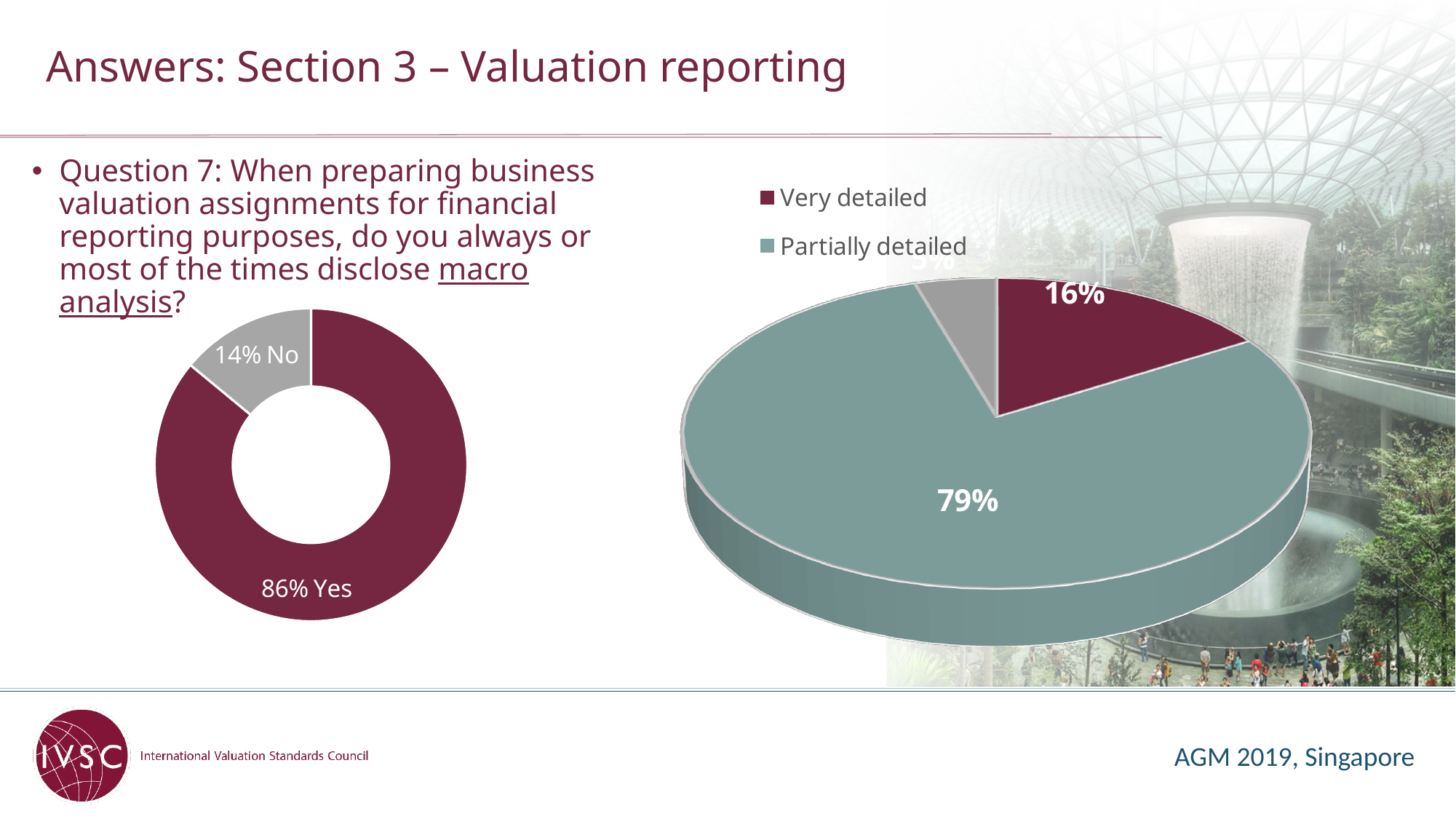
In the pie chart on the right, what percentage is labelled for Very detailed? 16% In the pie chart on the right, what percentage is labelled for Partially detailed? 79% What kind of chart is the chart on the right of the slide? Pie chart In the doughnut chart on the left, which answer has the larger share, Yes or No? Yes In the doughnut chart on the left, how many percentage points larger is the Yes share than the No share? 72 percentage points In the pie chart on the right, how many percentage points larger is Partially detailed than Very detailed? 63 percentage points In the doughnut chart on the left, what percentage of respondents answered Yes? 86% In the pie chart on the right, what colour is the Very detailed slice? Dark red (maroon) In the pie chart on the right, which category has the largest slice? Partially detailed In the doughnut chart on the left, what percentage of respondents answered No? 14% How many categories does the doughnut chart on the left show? 2 What kind of chart is the chart on the left of the slide? Doughnut chart